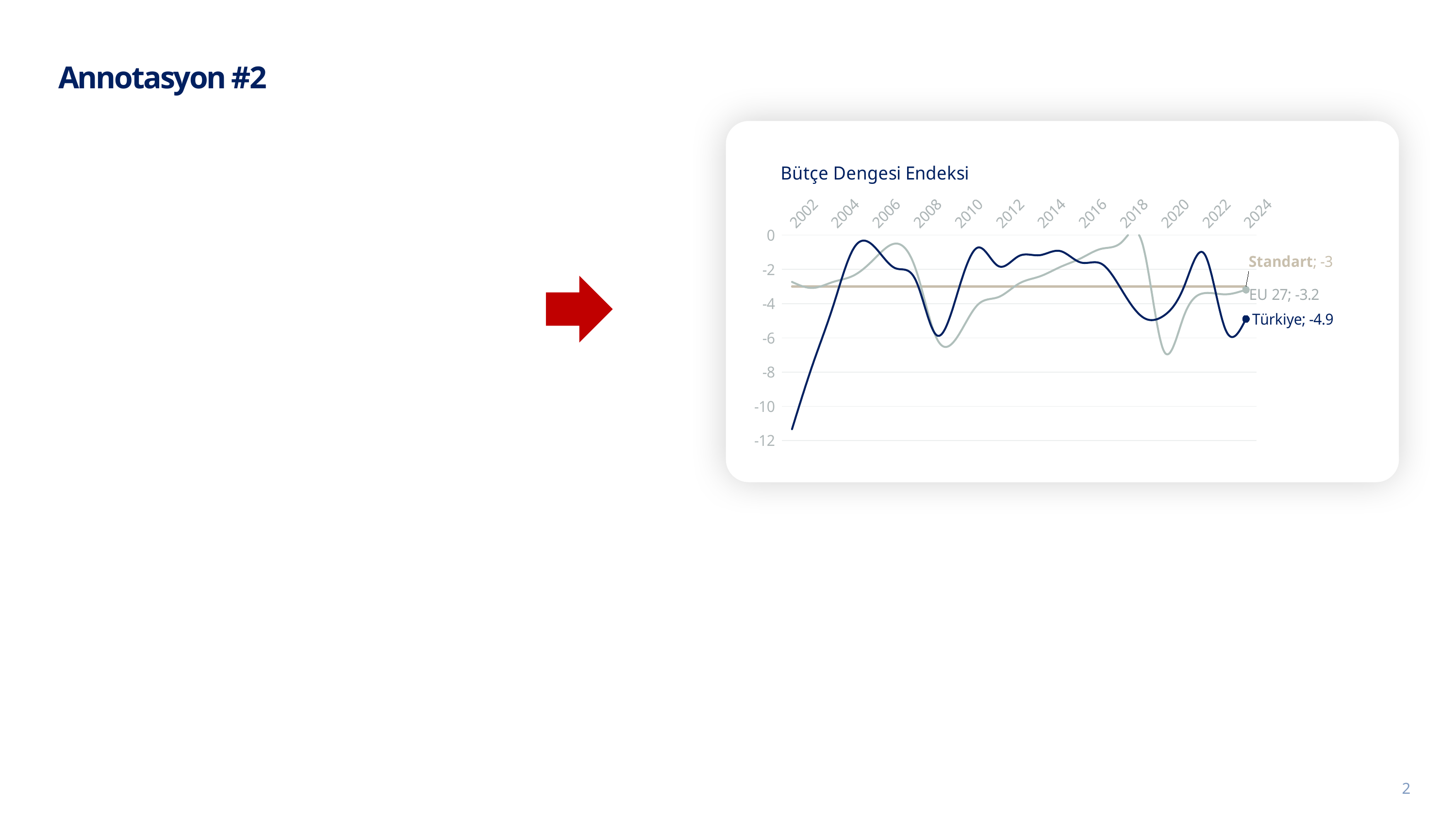
Is the value for EU 27 around 2020 greater or less than -6? less Is the value for Türkiye in 2002 greater or less than -10? less At the end of the series, which is higher: EU 27 or Türkiye? EU 27 What is the final labelled value for EU 27? -3.2 What is the final labelled value for Türkiye? -4.9 What type of chart is shown on the slide? line chart What is the title of the chart? Bütçe Dengesi Endeksi How many year labels are shown on the x axis? 12 Which of the three labelled series has the lowest final value? Türkiye What is the difference between the final labelled values of EU 27 (-3.2) and Türkiye (-4.9)? 1.7 Does the Türkiye line rise or fall between 2002 and 2005? rise What value is the Standart line labelled with? -3